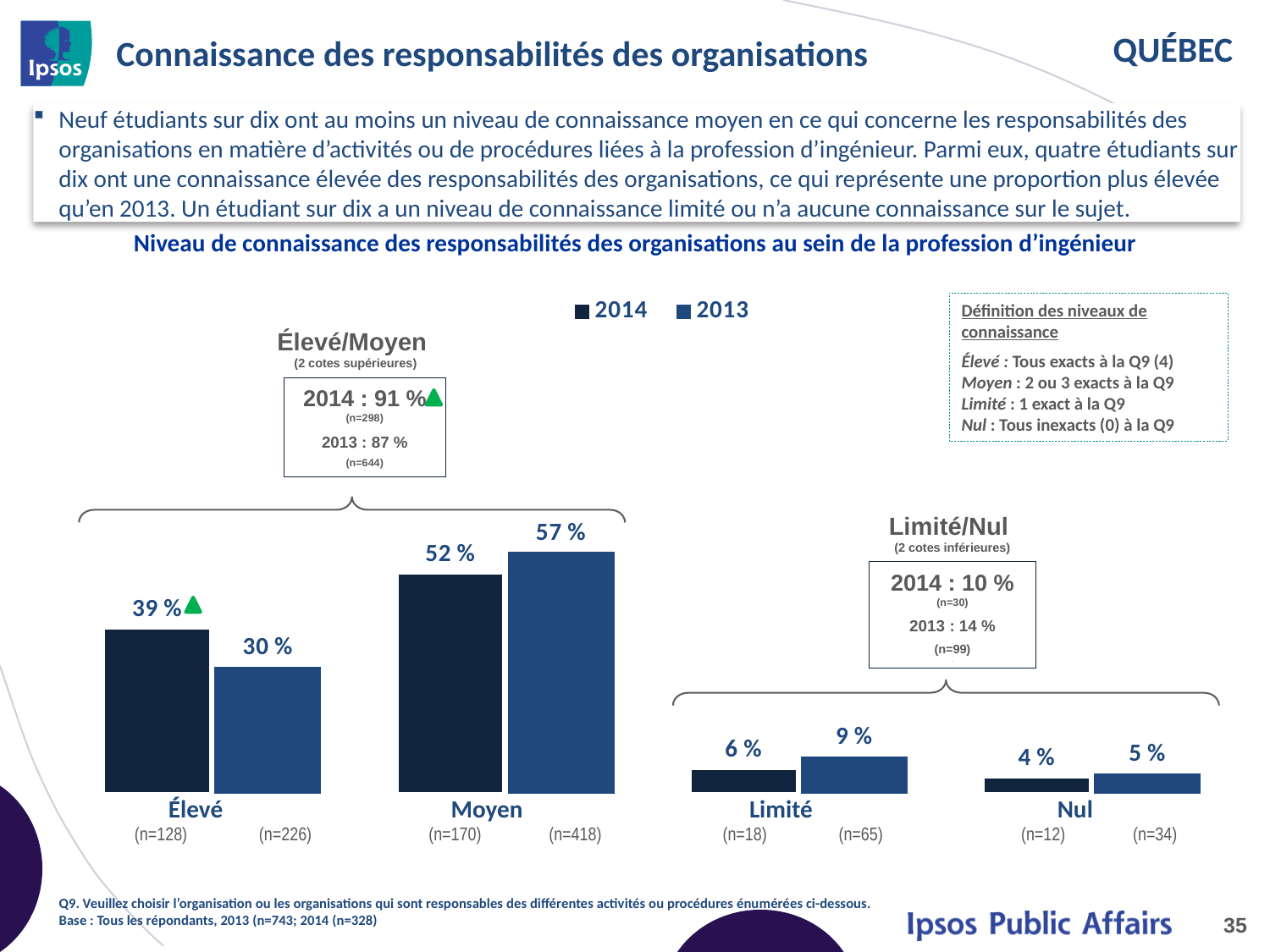
Which category has the lowest 2014 value? Nul What is the 2013 value for Élevé? 30 % How many series does the legend list? 2 For Élevé, which year has the larger value, 2014 or 2013? 2014 What is the difference between the 2014 and 2013 values for Élevé? 9 % What kind of chart is shown on the slide? Bar chart What is the difference between the 2013 and 2014 values for Moyen? 5 % What is the 2014 value for Nul? 4 % What is the 2014 value for Moyen? 52 % How many categories are shown on the x axis of the chart? 4 What is the 2013 value for Limité? 9 % Which category has the highest 2013 value? Moyen